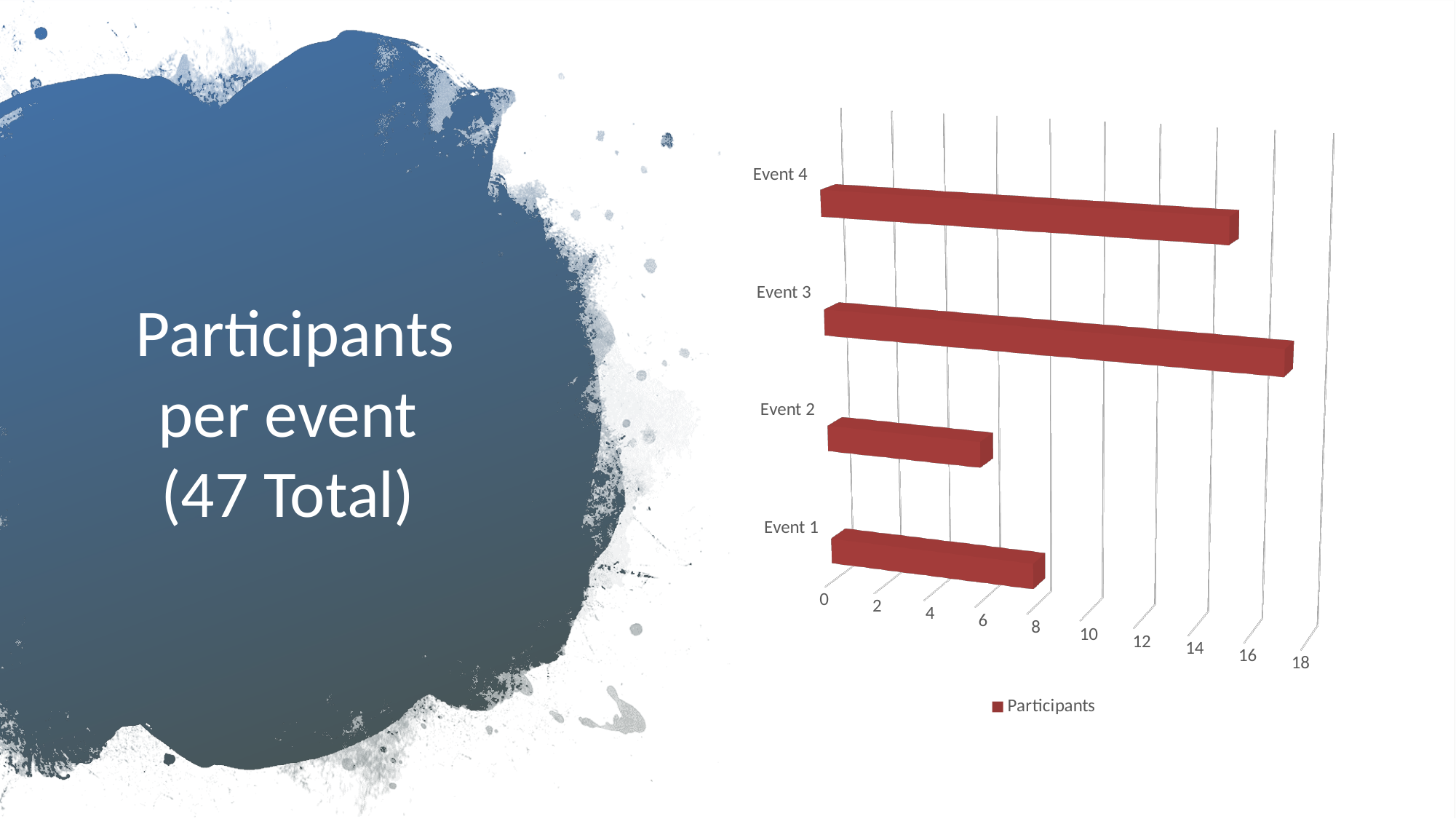
Which has more participants, Event 1 or Event 2? Event 1 Is the value for Event 4 greater or less than 12? greater What series name is shown in the chart legend? Participants Which has more participants, Event 3 or Event 4? Event 3 Which event has the highest number of participants? Event 3 What kind of chart is shown on the slide? bar chart Is the value for Event 2 greater or less than 8? less Which event has the lowest number of participants? Event 2 Is the value for Event 3 greater or less than 14? greater How many series does the chart legend list? 1 According to the slide title, what is the total number of participants across all events? 47 How many events are plotted in the chart? 4